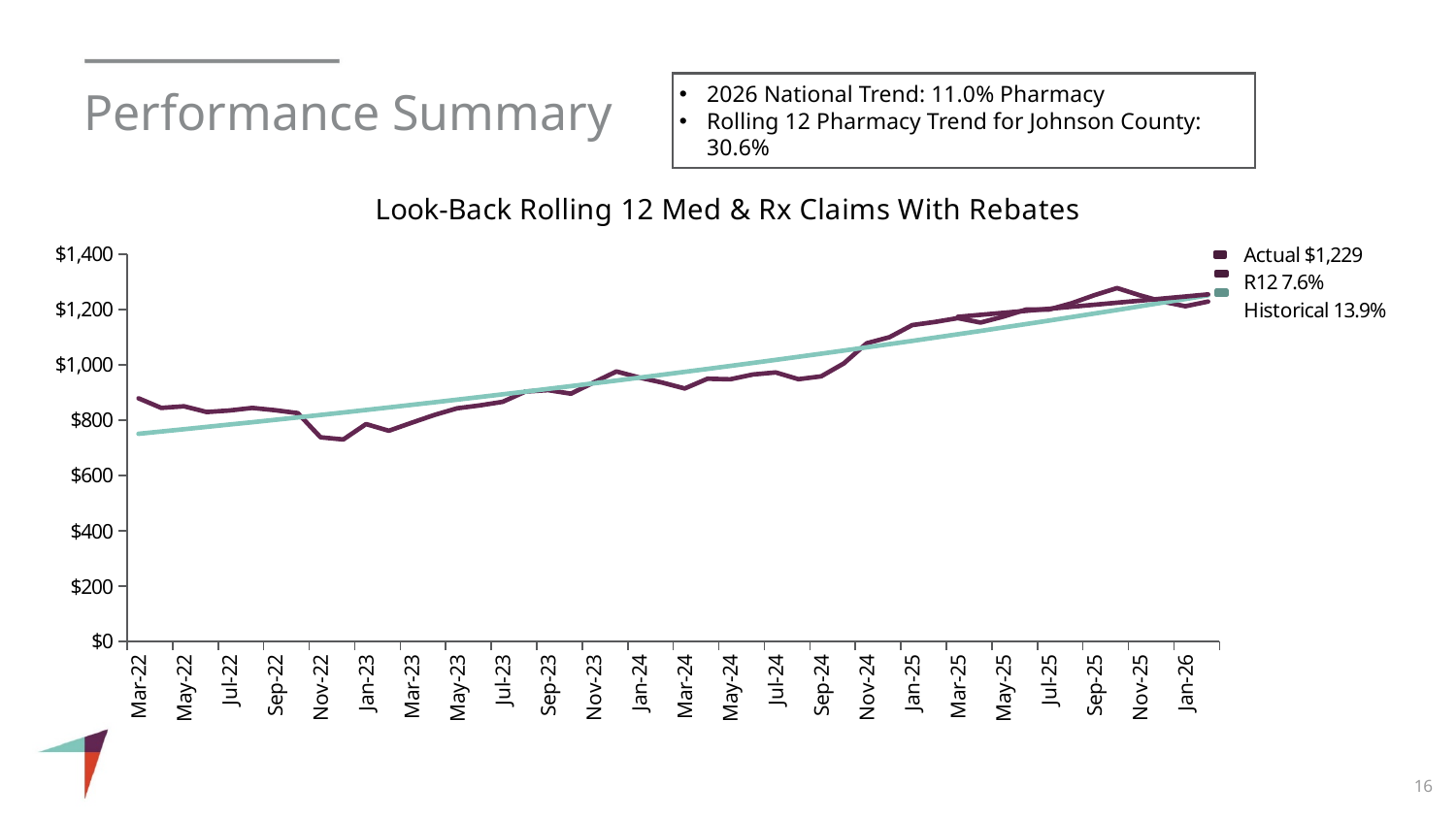
What is the title of the chart? Look-Back Rolling 12 Med & Rx Claims With Rebates Is the Actual value at Jan-25 greater or less than $1,000? greater Is the Historical line at Mar-22 greater or less than $800? less Which is larger, the Actual value at Jan-25 or the Actual value at Mar-22? Jan-25 Is the Actual value at Mar-22 greater or less than $800? greater What kind of chart is shown on the slide? line chart How many series does the chart legend list? 3 Does the Actual line generally rise or fall from Mar-22 to Jan-26? rise How many date labels are shown on the x axis? 24 What value is shown next to 'Actual' in the chart legend? $1,229 What percentage is shown next to 'Historical' in the chart legend? 13.9%